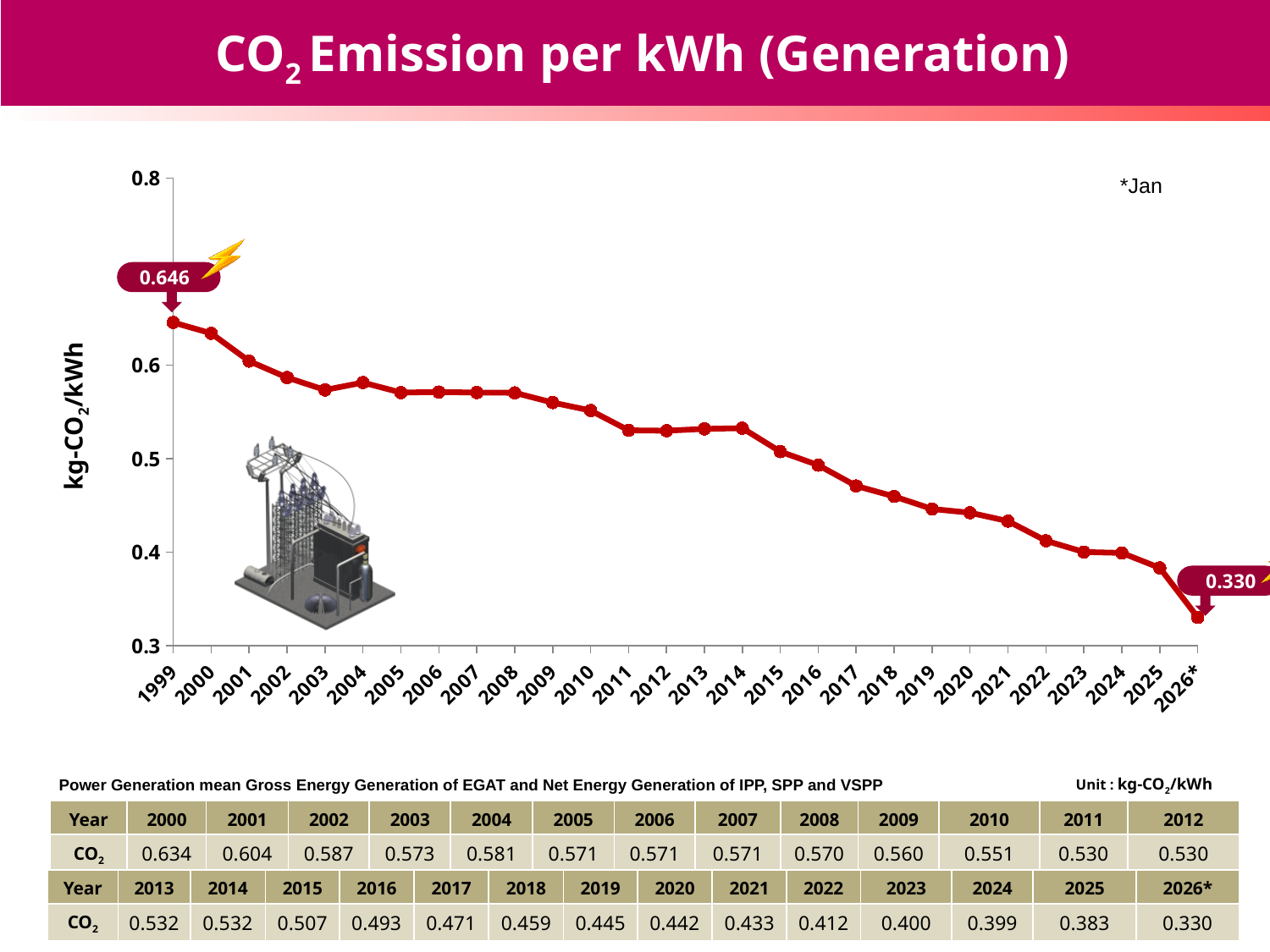
Which year has the highest CO2 emission per kWh? 1999 What is the difference between the 1999 value (0.646) and the 2026* value (0.330)? 0.316 How many years are plotted on the x axis? 28 According to the table, what is the CO2 value for 2020? 0.442 According to the table, what is the CO2 value for 2010? 0.551 What type of chart is shown on the slide? line chart What is the CO2 emission per kWh value labelled for 2026*? 0.330 Which year has the lowest CO2 emission per kWh? 2026* Is the value for 2017 greater or less than 0.5? less What is the CO2 emission per kWh value labelled for 1999? 0.646 Do the values generally rise or fall from 1999 to 2026*? fall Which year has a higher CO2 value, 2004 or 2015? 2004